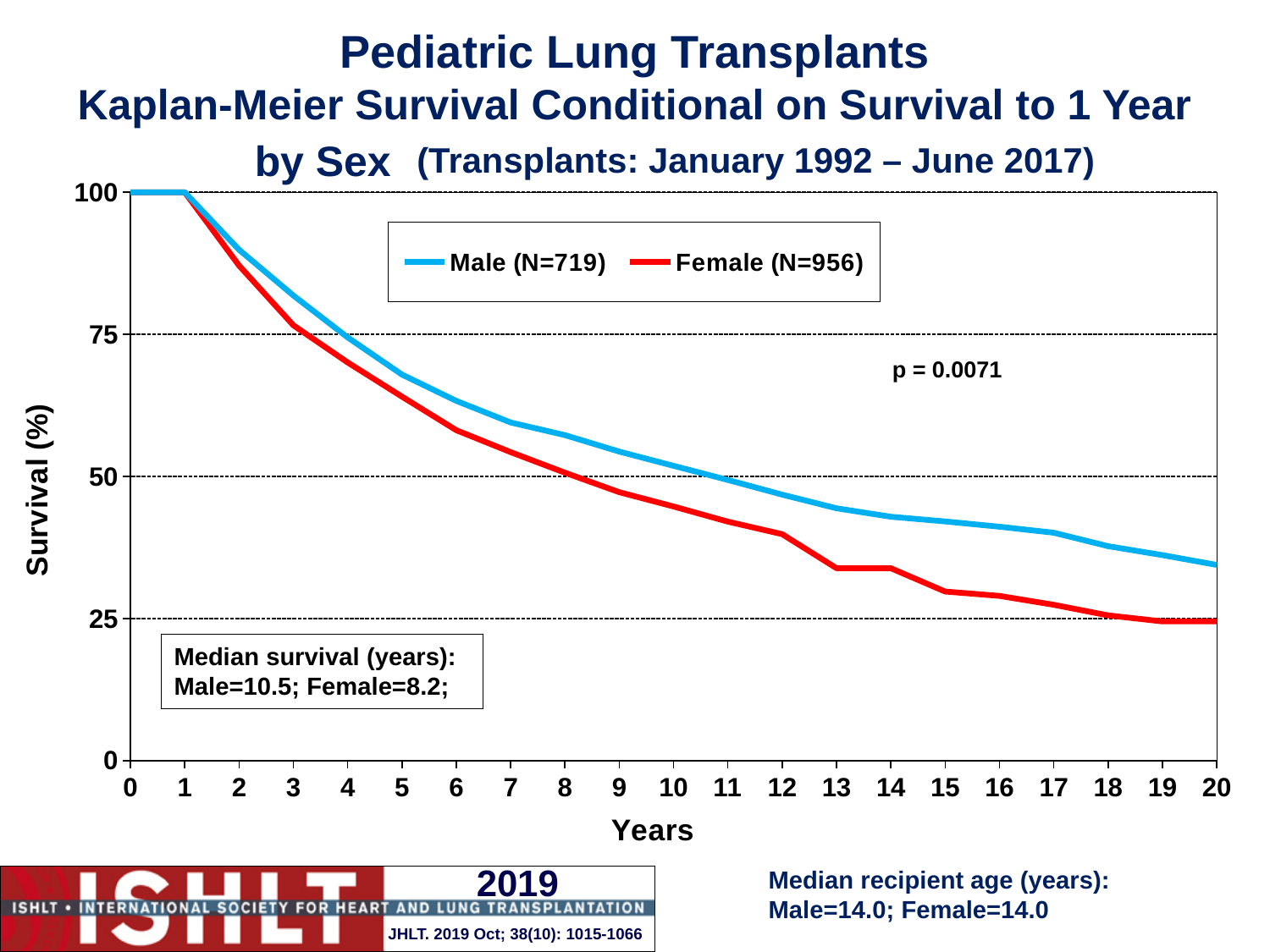
Is the Male survival value at 20 years greater or less than 25? greater How many series does the legend list? 2 What is the median survival in years for males, as printed on the slide? 10.5 What is the N for the Female series in the legend? 956 What kind of chart is shown on the slide? line chart What is the p-value shown on the chart? p = 0.0071 Is the Female survival value at 12 years greater or less than 50? less What is the median survival in years for females, as printed on the slide? 8.2 What is the N for the Male series in the legend? 719 Do the survival curves rise or fall as years increase? fall Which series has the higher median survival, Male or Female? Male What is the difference in median survival (years) between males and females? 2.3